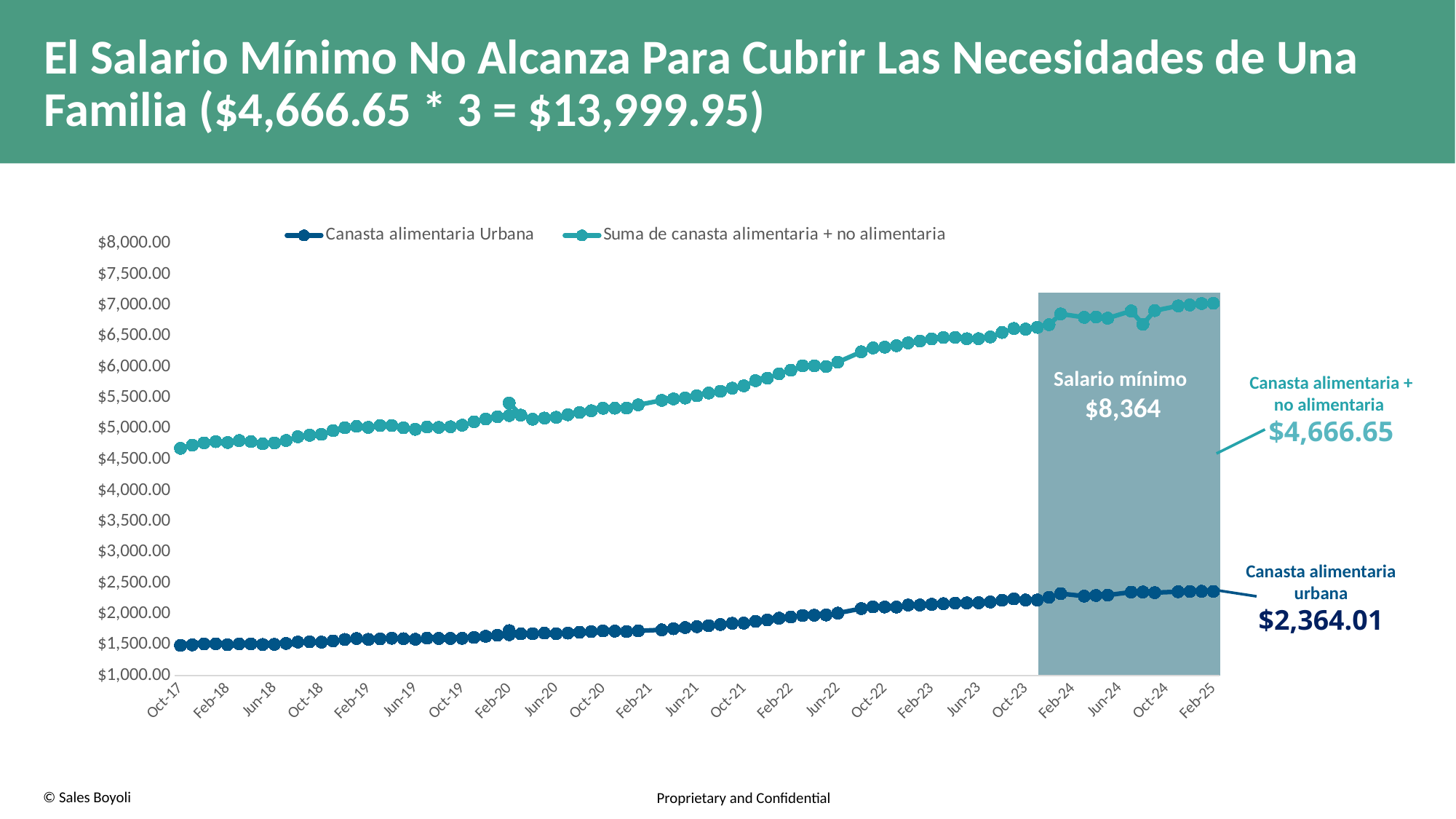
What is the highest value shown on the chart's y axis? $8,000.00 Is the value for Suma de canasta alimentaria + no alimentaria at Oct-17 greater or less than $5,000.00? less What type of chart is shown on the slide? line chart Is the value for Canasta alimentaria Urbana at Feb-25 greater or less than $2,000.00? greater Is the value for Canasta alimentaria Urbana at Oct-17 greater or less than $2,000.00? less Does the Canasta alimentaria Urbana series rise or fall from Oct-17 to Feb-25? rises Which series is plotted higher on the chart, Canasta alimentaria Urbana or Suma de canasta alimentaria + no alimentaria? Suma de canasta alimentaria + no alimentaria What value is annotated for Canasta alimentaria urbana at the right end of the chart? $2,364.01 What Salario mínimo value is shown in the shaded region of the chart? $8,364 How many series does the chart legend list? 2 What are the two series named in the chart legend? Canasta alimentaria Urbana; Suma de canasta alimentaria + no alimentaria